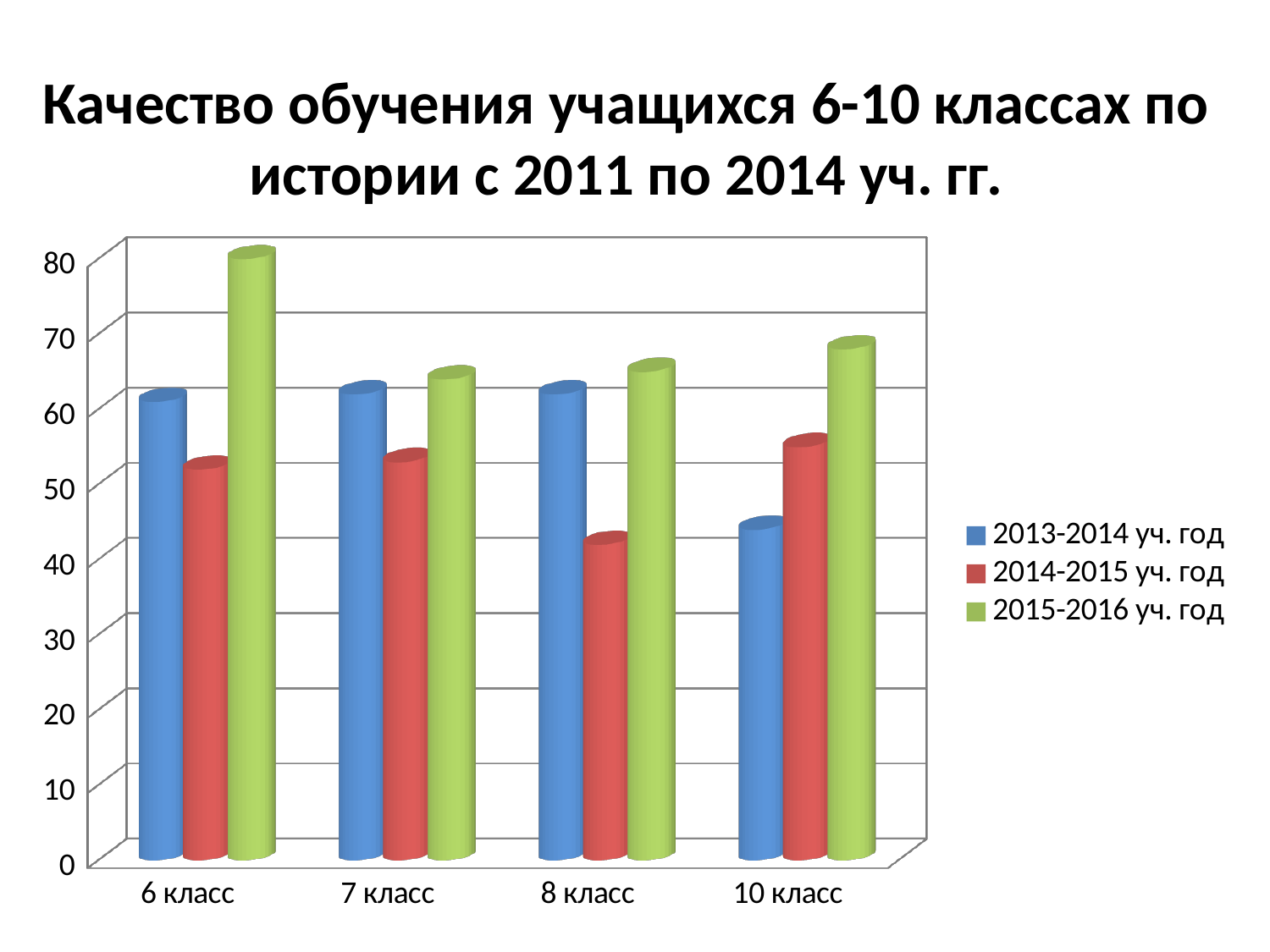
How many series does the legend list? 3 Which class has the lowest value for the 2013-2014 уч. год series? 10 класс How many class categories are shown on the x axis? 4 Is the value for 10 класс in 2013-2014 уч. год greater or less than 50? less What kind of chart is shown on the slide? Bar chart For 8 класс, which series has the larger value: 2013-2014 уч. год or 2014-2015 уч. год? 2013-2014 уч. год Is the value for 8 класс in 2014-2015 уч. год greater or less than 50? less Which class has the lowest value for the 2014-2015 уч. год series? 8 класс Which colour represents the 2015-2016 уч. год series in the legend? Green Which class has the highest value for the 2015-2016 уч. год series? 6 класс For 10 класс, which series has the larger value: 2013-2014 уч. год or 2014-2015 уч. год? 2014-2015 уч. год Is the value for 6 класс in 2015-2016 уч. год greater or less than 70? greater